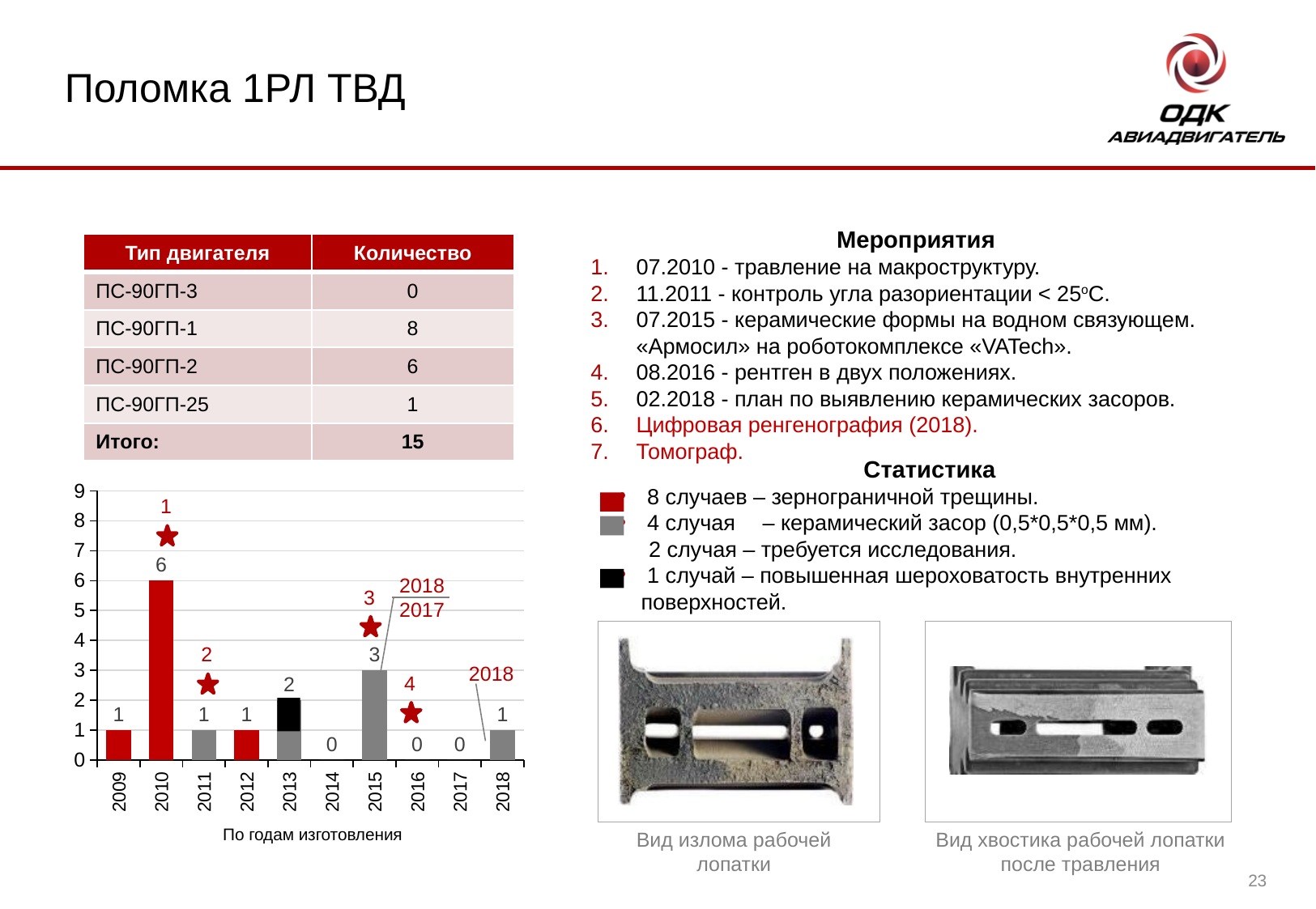
What is the value for 2010 in the bar chart? 6 Which year has the larger value in the bar chart, 2015 or 2013? 2015 Which year has the highest value in the bar chart? 2010 What kind of chart is shown on the slide? bar chart How many years are shown on the x axis of the bar chart? 10 What is the x-axis title of the bar chart? По годам изготовления What is the value for 2015 in the bar chart? 3 How many years in the bar chart have a value of 0? 3 What is the value for 2013 in the bar chart? 2 Is the value for 2010 in the bar chart greater or less than 5? greater What is the value for 2018 in the bar chart? 1 What is the difference between the values for 2010 and 2015 in the bar chart? 3